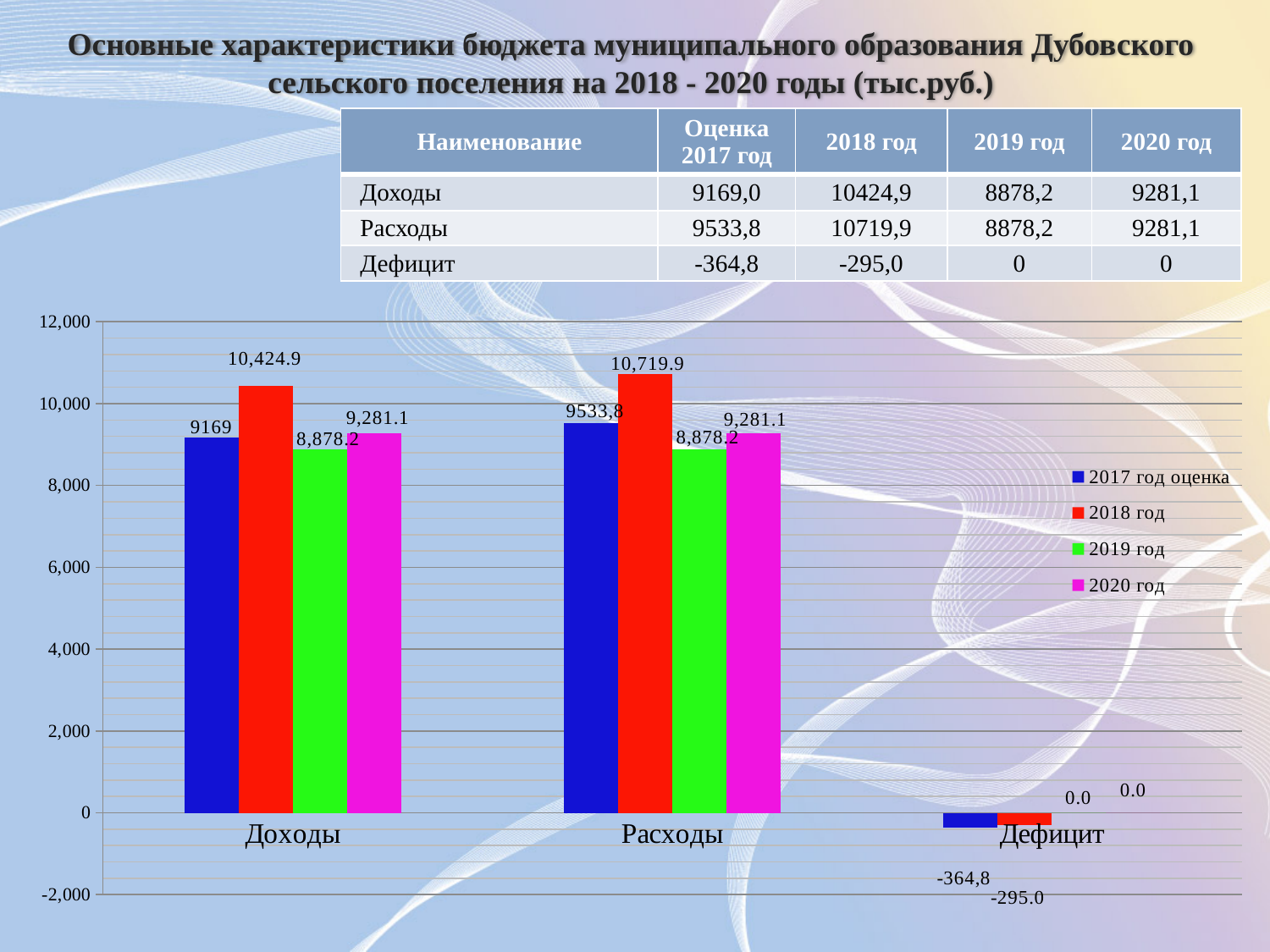
What kind of chart is shown on the slide? Bar chart How many categories are shown on the x axis? 3 What is the value of the 2017 год оценка bar for Дефицит? -364,8 How many series does the legend list? 4 What is the value of the 2018 год bar for Расходы? 10,719.9 Which year's bar is the lowest in the Доходы group? 2019 год What is the value of the 2018 год bar for Дефицит? -295.0 Which is larger: the 2020 год bar for Доходы or the 2019 год bar for Доходы? 2020 год bar for Доходы What is the value of the 2017 год оценка bar for Расходы? 9533,8 What is the difference between the 2018 год bars for Расходы and Доходы? 295.0 Which year's bar is the highest in the Расходы group? 2018 год What is the value of the 2018 год bar for Доходы? 10,424.9